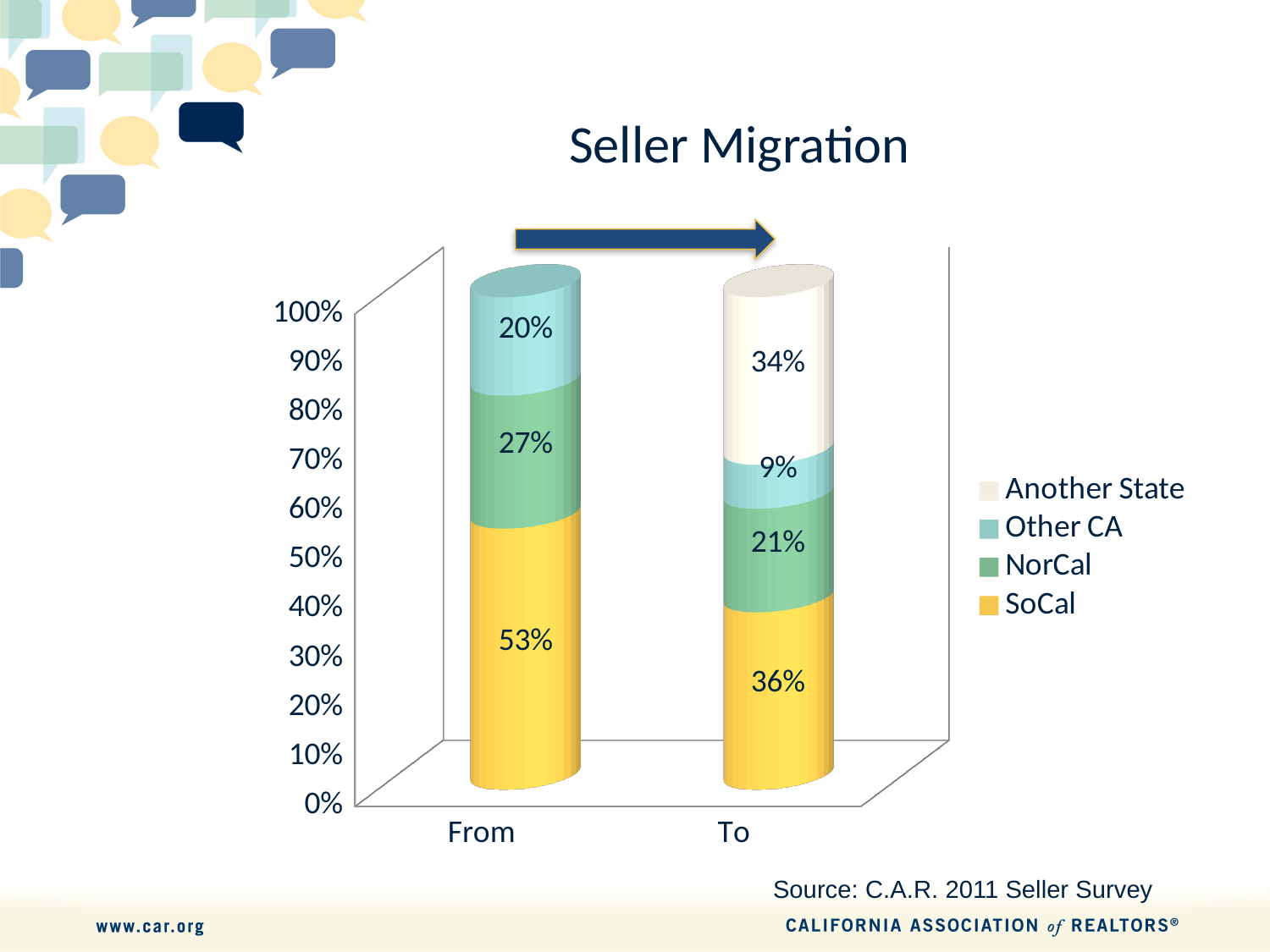
Which segment is the smallest in the To bar? Other CA What is the SoCal value for the From bar? 53% Which segment is the largest in the To bar? SoCal What kind of chart is shown? Stacked bar chart How many series does the legend list? 4 How many categories are shown on the x axis? 2 Which is larger, the NorCal value for From or the NorCal value for To? From What is the difference between the SoCal values for From and To? 17% What is the Other CA value for the To bar? 9% What is the title of the chart? Seller Migration What is the NorCal value for the From bar? 27% What is the Another State value for the To bar? 34%